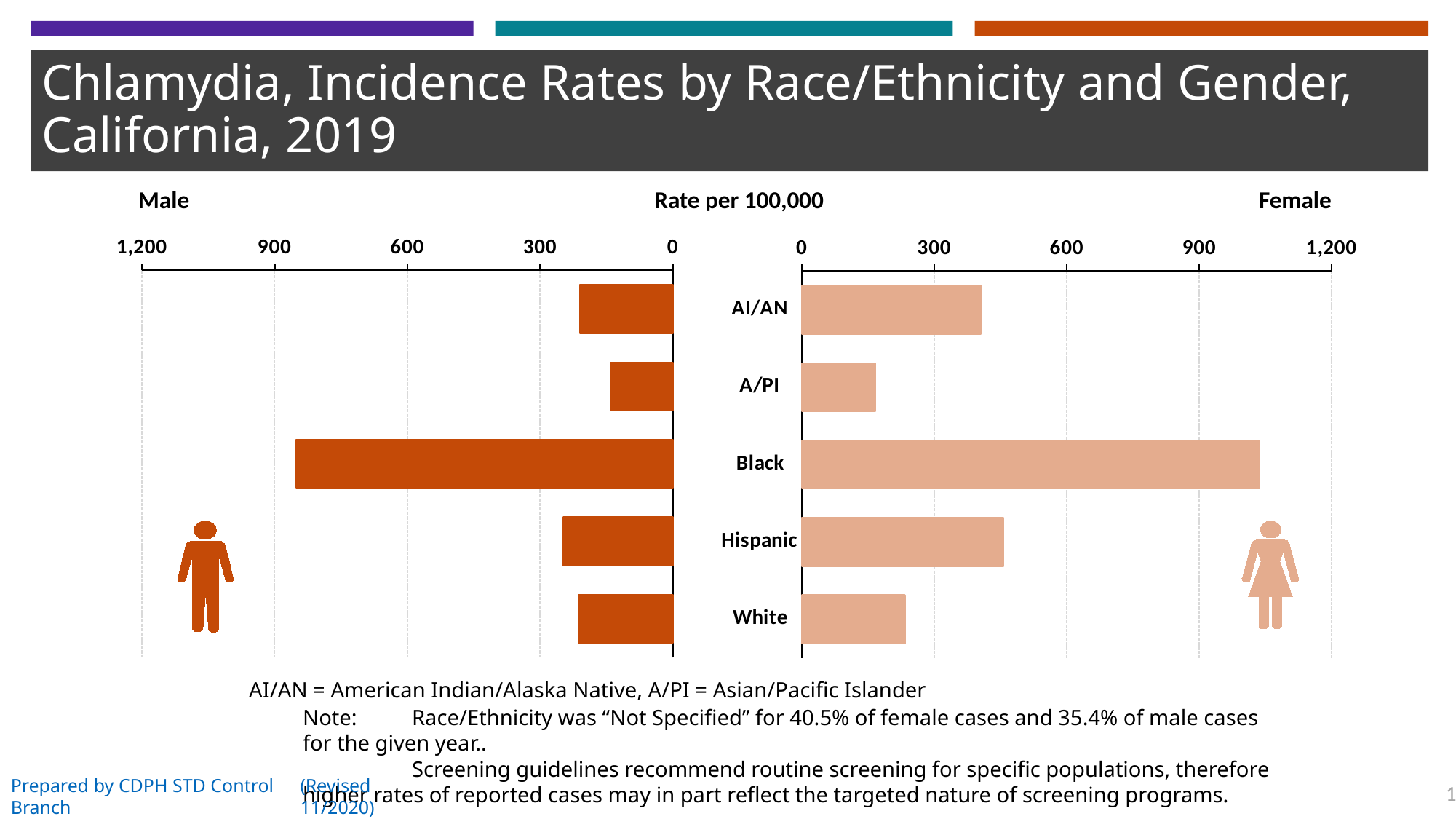
Is the male rate for Hispanic greater or less than 300? less Is the female rate for Black greater or less than 900? greater Which race/ethnicity has the lowest male chlamydia incidence rate? A/PI Which is larger, the female rate for Black or the male rate for Black? female rate for Black What unit is the rate expressed in, according to the label above the chart? Rate per 100,000 Which race/ethnicity has the highest female chlamydia incidence rate? Black Is the male rate for Black greater or less than 600? greater Which race/ethnicity has the highest male chlamydia incidence rate? Black Which race/ethnicity has the lowest female chlamydia incidence rate? A/PI How many race/ethnicity categories are plotted in the chart? 5 What kind of chart is shown on the slide? bar chart